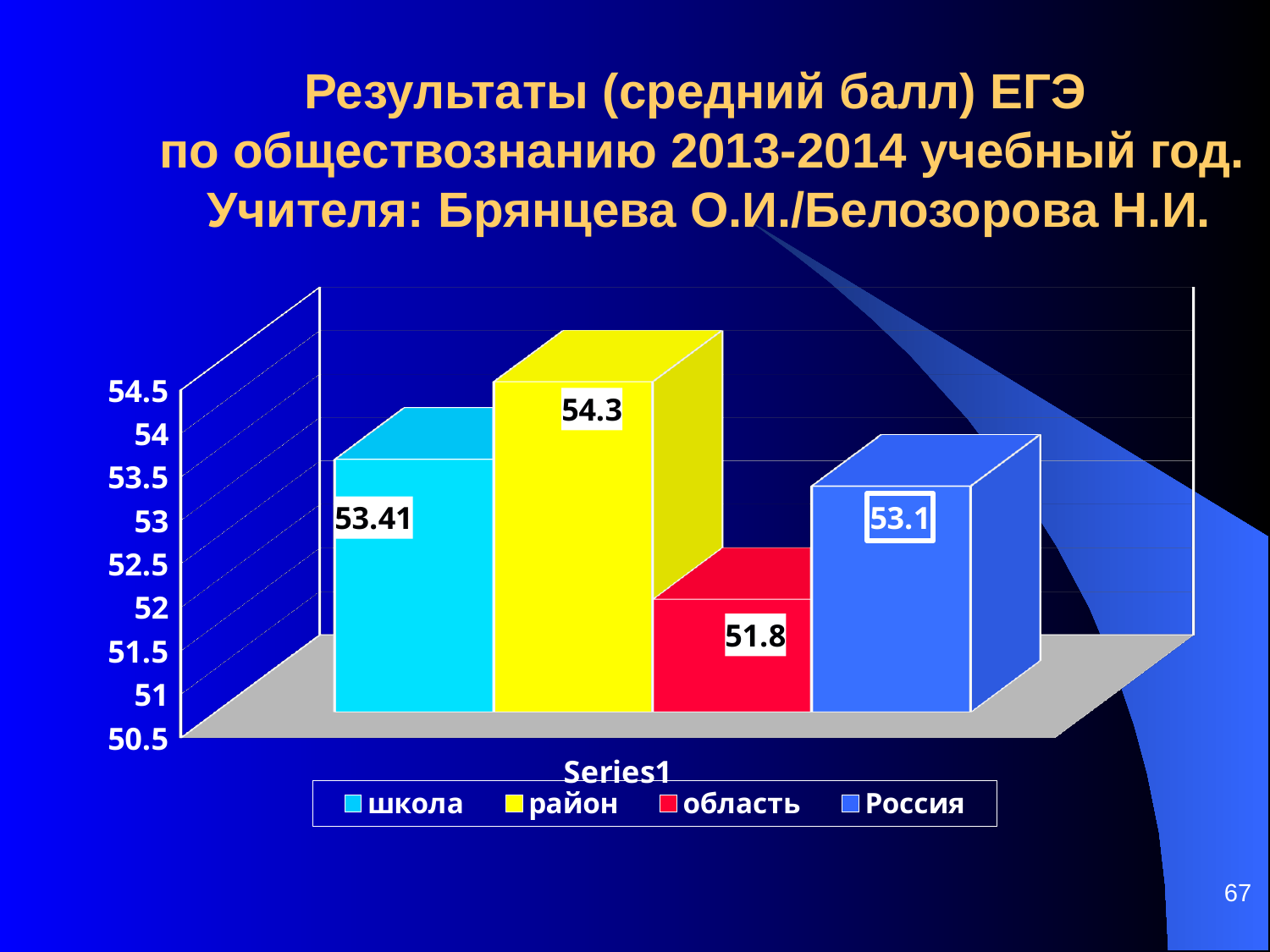
What kind of chart is shown on the slide? bar chart Which is larger, the value for школа or the value for Россия? школа What is the difference between the values for район and область? 2.5 What is the value for школа? 53.41 What is the value for Россия? 53.1 What is the value for область? 51.8 How many bars are plotted in the chart? 4 What is the value for район? 54.3 How many entries does the legend list? 4 What is the difference between the values for школа and Россия? 0.31 Which category has the highest value? район Which category has the lowest value? область